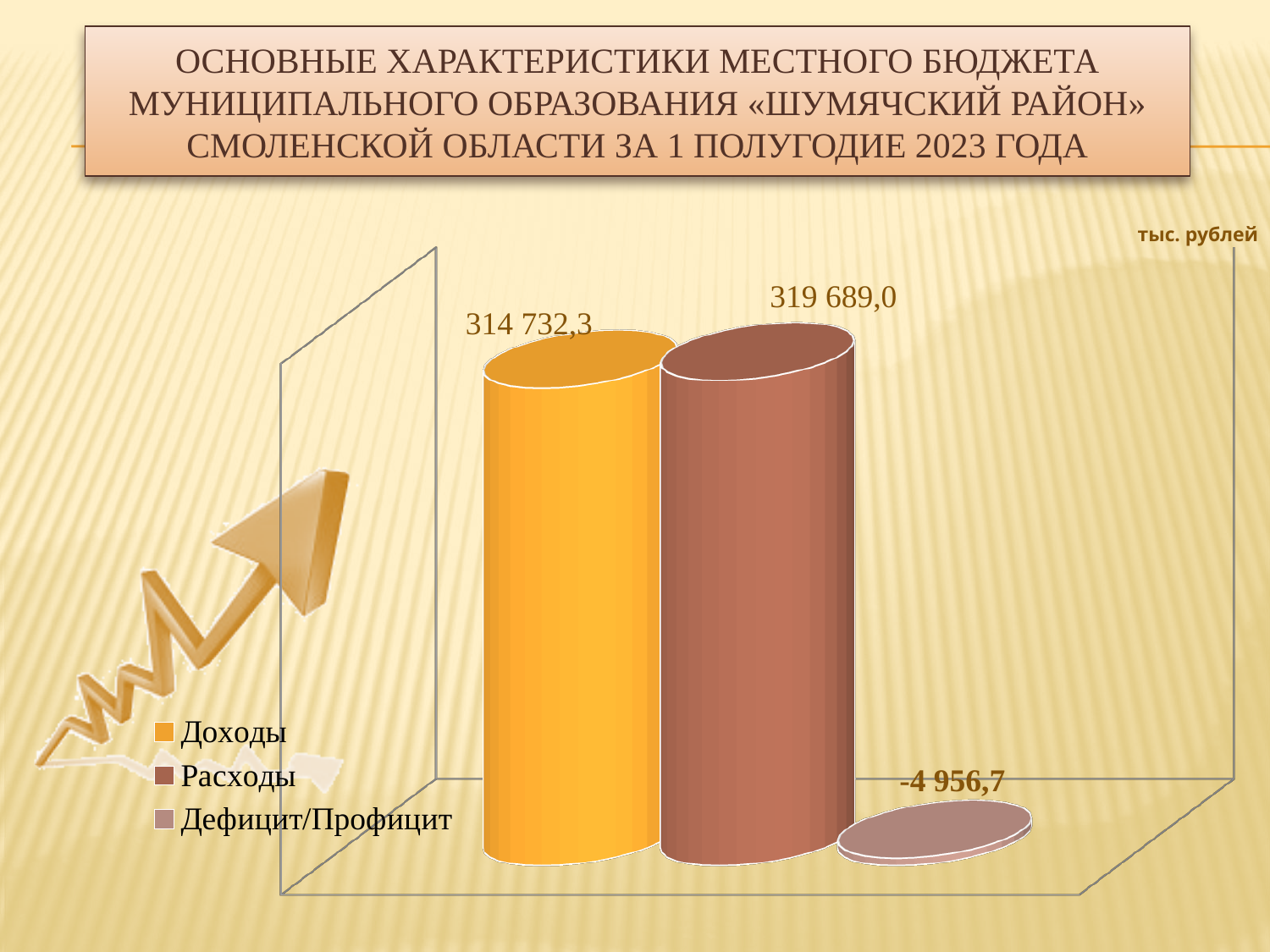
Which series has the highest value? Расходы What is the value shown for Доходы? 314 732,3 What unit is indicated for the values on the chart? тыс. рублей What colour is the bar for Доходы? Orange/yellow What kind of chart is shown on the slide? Bar chart What is the value shown for Дефицит/Профицит? -4 956,7 Which is larger, Доходы or Расходы? Расходы How many series does the legend list? 3 Which series has the lowest value? Дефицит/Профицит What is the value shown for Расходы? 319 689,0 How many bars are plotted on the chart? 3 What is the difference between Расходы and Доходы? 4 956,7